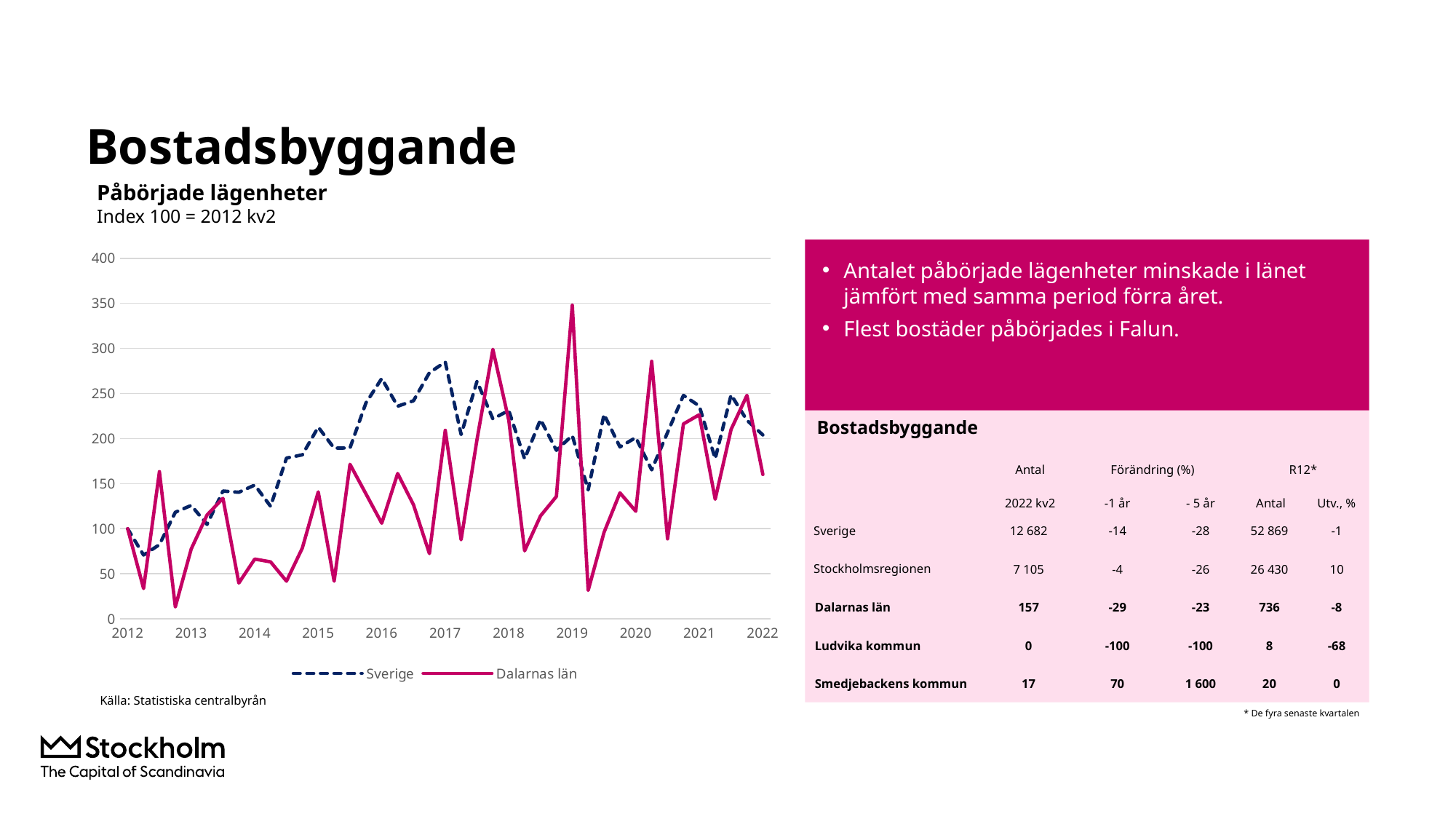
What kind of chart is shown on the slide? line chart Which two series are listed in the chart's legend? Sverige and Dalarnas län Is the highest value reached by the Dalarnas län line greater or less than 300? greater At the final point in 2022, which series has the higher value, Sverige or Dalarnas län? Sverige Is the value of the Sverige line at the final point in 2022 greater or less than 150? greater How many series does the chart's legend list? 2 What is the index value of both series at the first point in 2012? 100 Is the lowest value reached by the Dalarnas län line greater or less than 50? less Which series reaches the higher peak value over the whole period? Dalarnas län Does the Sverige line generally rise or fall between 2012 and 2017? rise What is the index base period stated under the chart title? Index 100 = 2012 kv2